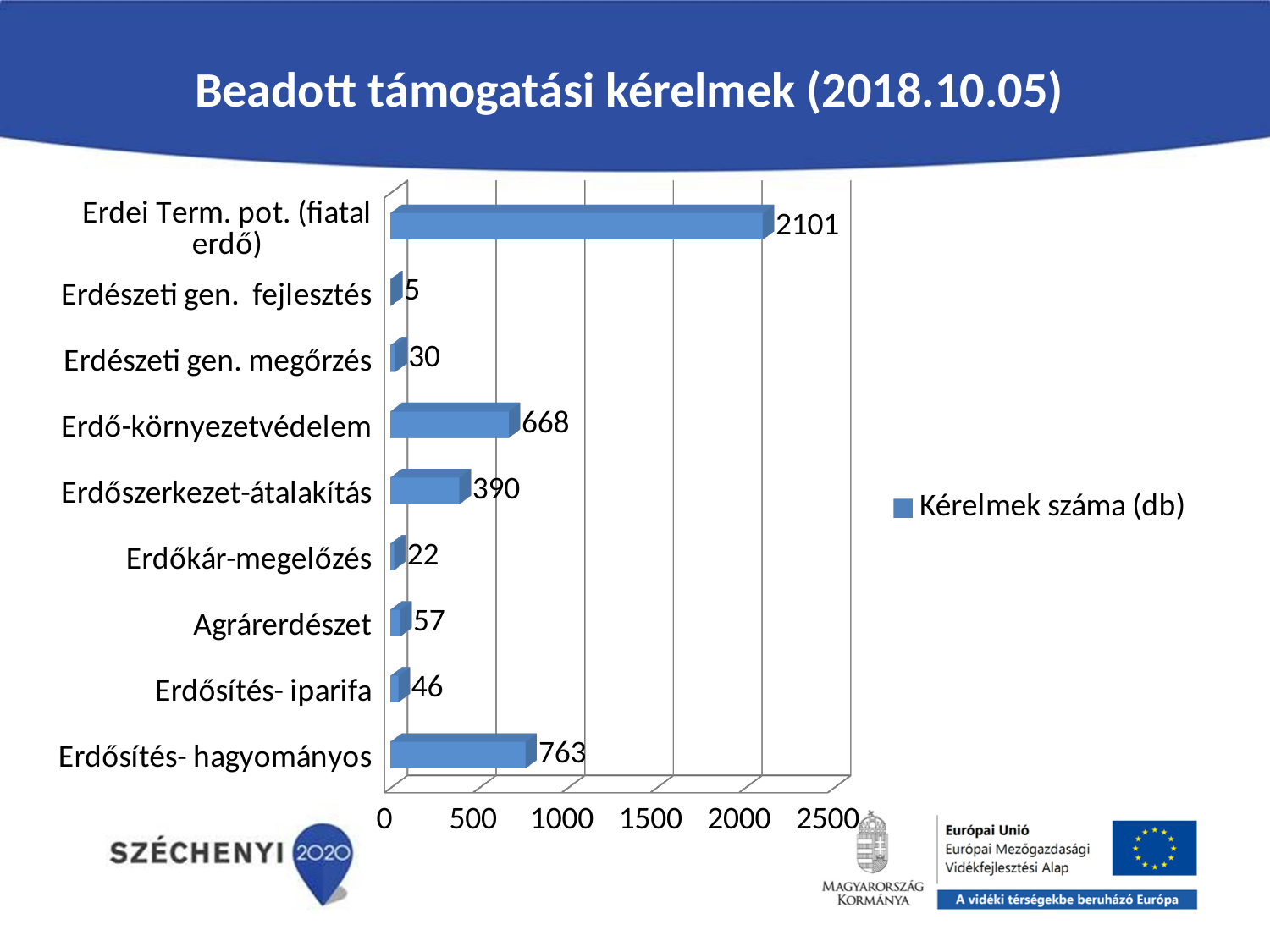
Which category has the highest number of applications? Erdei Term. pot. (fiatal erdő) What is the difference between Erdősítés- hagyományos and Erdő-környezetvédelem? 95 Which is larger, Agrárerdészet or Erdősítés- iparifa? Agrárerdészet What kind of chart is shown on the slide? bar chart What is the legend entry of the chart? Kérelmek száma (db) Is the value for Erdő-környezetvédelem greater or less than 500? greater How many series does the legend list? 1 What is the value for Erdősítés- hagyományos? 763 Which category has the lowest number of applications? Erdészeti gen. fejlesztés What is the value for Erdőszerkezet-átalakítás? 390 How many categories are shown in the chart? 9 What is the value for Erdei Term. pot. (fiatal erdő)? 2101